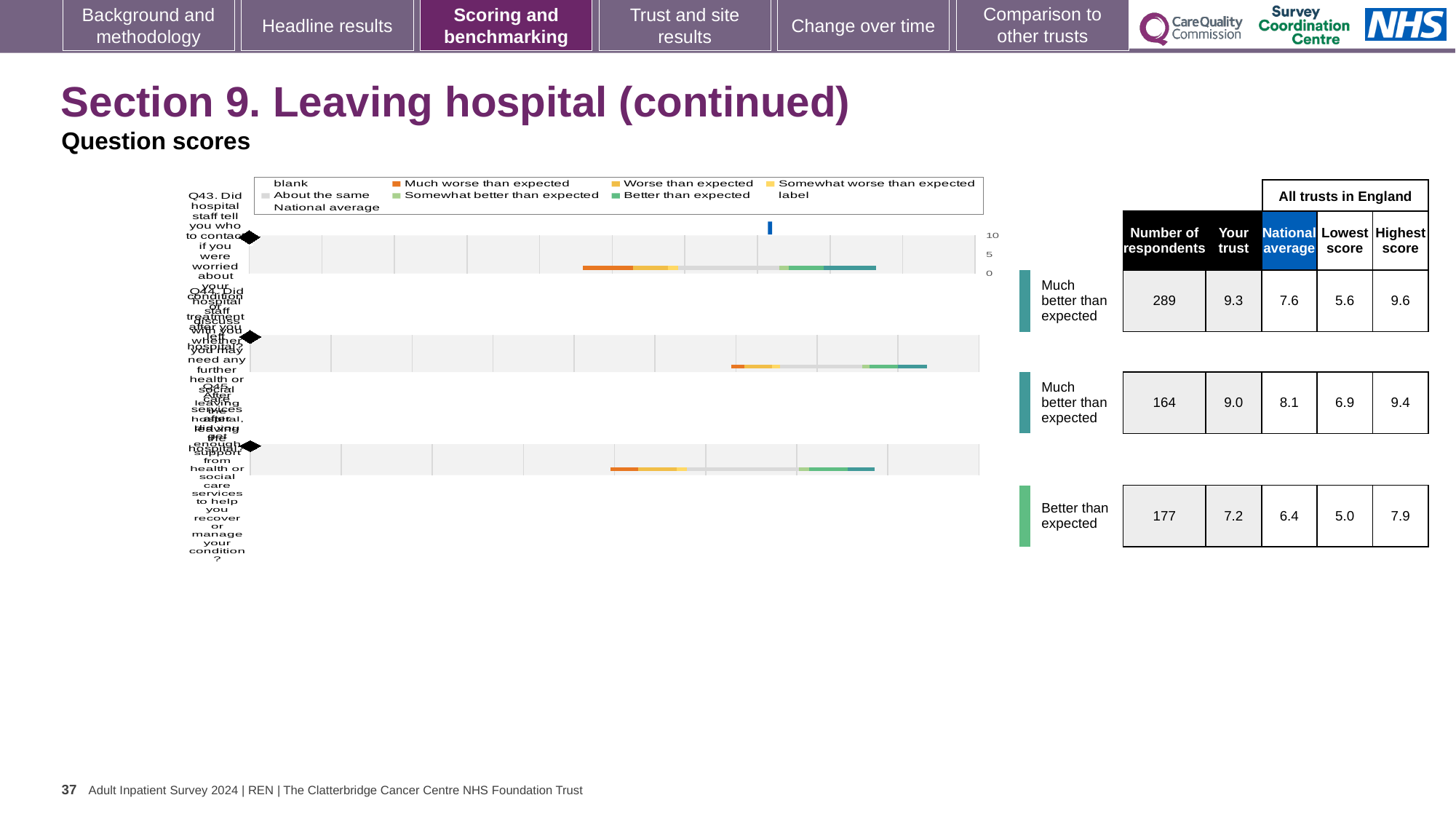
Which question row has the lowest national average? The third row (Q45), 6.4 What is the national average for the first question row (Q43)? 7.6 For the second question row (Q44), which is larger: the 'Your trust' score or the national average? Your trust (9.0) What benchmark category is shown for the third question row (Q45)? Better than expected What is the number of respondents for the first question row (Q43)? 289 How many question rows are plotted in the chart? 3 What is the difference between the 'Your trust' score and the national average for the first question row (Q43)? 1.7 What is the lowest score among all trusts in England for the third question row (Q45)? 5.0 What benchmark category is shown for the first question row (Q43)? Much better than expected Which question row has the highest 'Your trust' score? The first row (Q43), 9.3 What is the highest score among all trusts in England for the second question row (Q44)? 9.4 What is the 'Your trust' score for the first question row (Q43)? 9.3